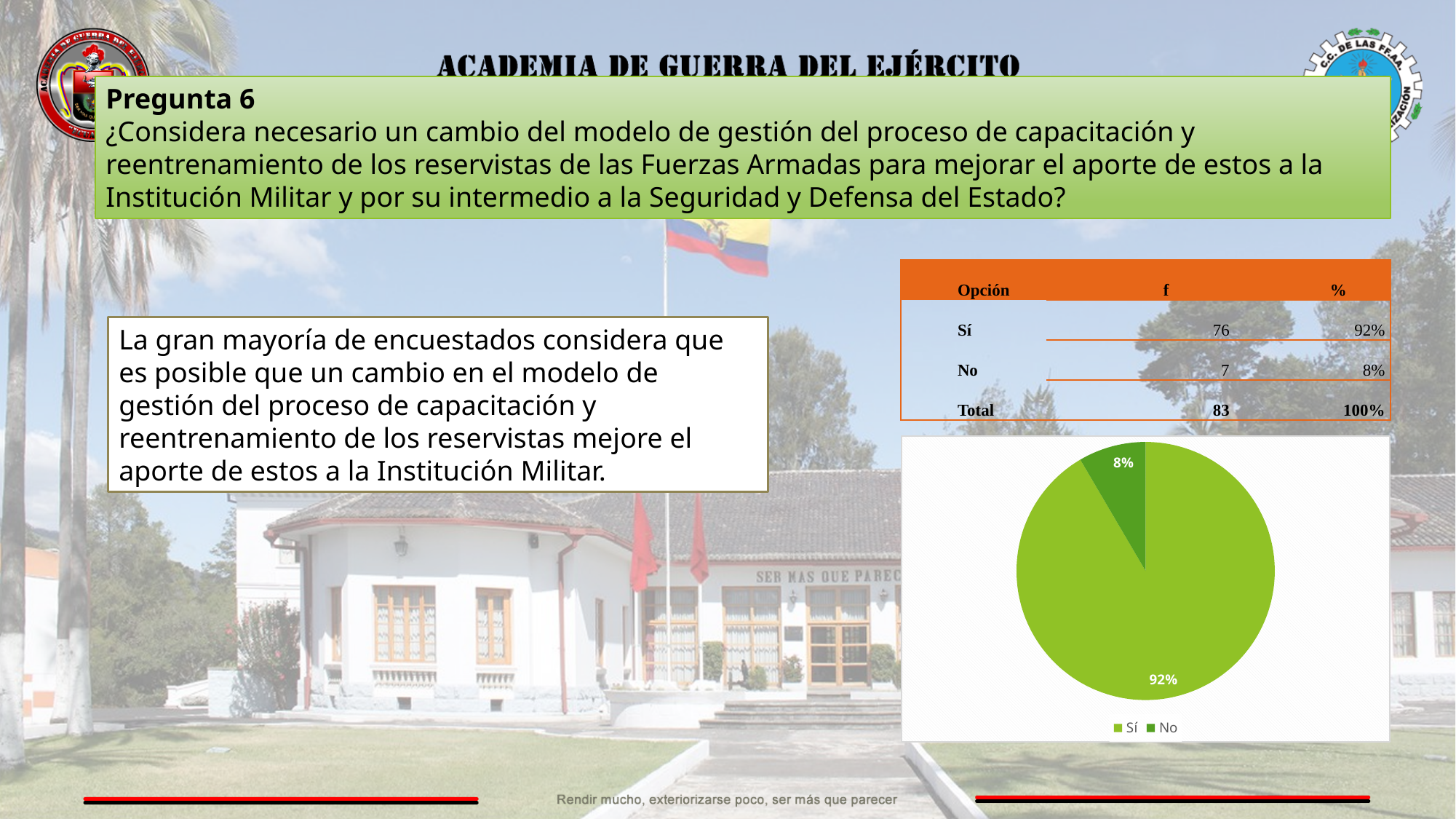
What share of the pie does the 'Sí' slice represent? 92% How many entries does the legend of the pie chart list? 2 What are the two legend entries of the pie chart? Sí and No What is the difference in percentage points between the 'Sí' slice and the 'No' slice? 84 percentage points What kind of chart is shown on the slide? pie chart Which slice of the pie chart is the smallest? No How many slices does the pie chart have? 2 Which legend entry is shown in the darker green colour? No Which is larger in the pie chart, the 'Sí' slice or the 'No' slice? Sí Which slice of the pie chart is the largest? Sí What share of the pie does the 'No' slice represent? 8%